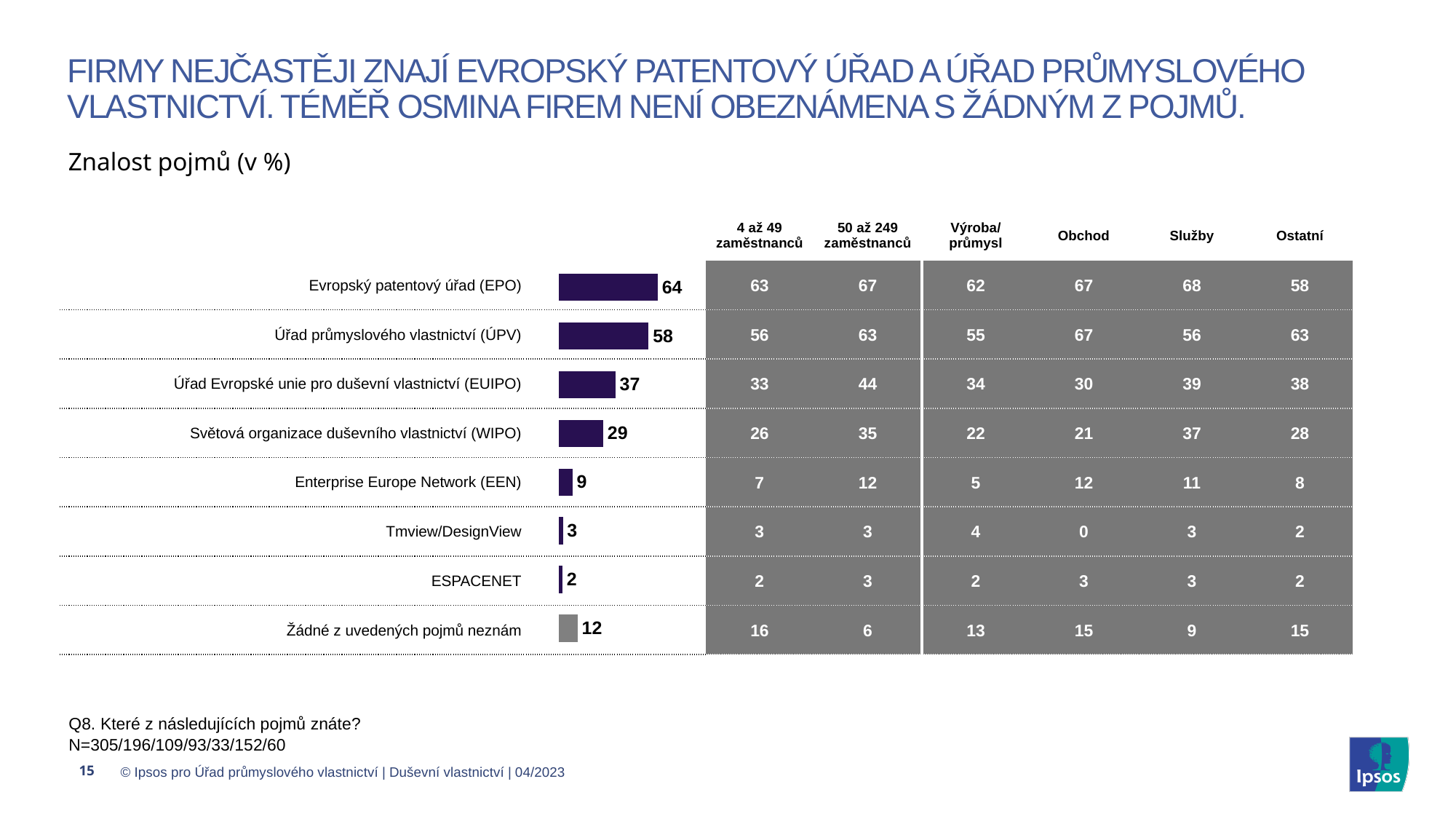
Which category has the highest value in the bar chart? Evropský patentový úřad (EPO) What is the value for Světová organizace duševního vlastnictví (WIPO) in the bar chart? 29 What is the value for Evropský patentový úřad (EPO) in the bar chart? 64 What kind of chart is shown on the slide? Bar chart What is the subtitle of the chart on the slide? Znalost pojmů (v %) What is the value for Žádné z uvedených pojmů neznám in the bar chart? 12 Which is larger in the bar chart: the value for Enterprise Europe Network (EEN) or the value for Žádné z uvedených pojmů neznám? Žádné z uvedených pojmů neznám How many categories are shown in the bar chart? 8 Which category has the lowest value in the bar chart? ESPACENET What is the value for Enterprise Europe Network (EEN) in the bar chart? 9 What is the difference between the values for Evropský patentový úřad (EPO) and Úřad průmyslového vlastnictví (ÚPV) in the bar chart? 6 What is the difference between the values for Úřad Evropské unie pro duševní vlastnictví (EUIPO) and Světová organizace duševního vlastnictví (WIPO) in the bar chart? 8